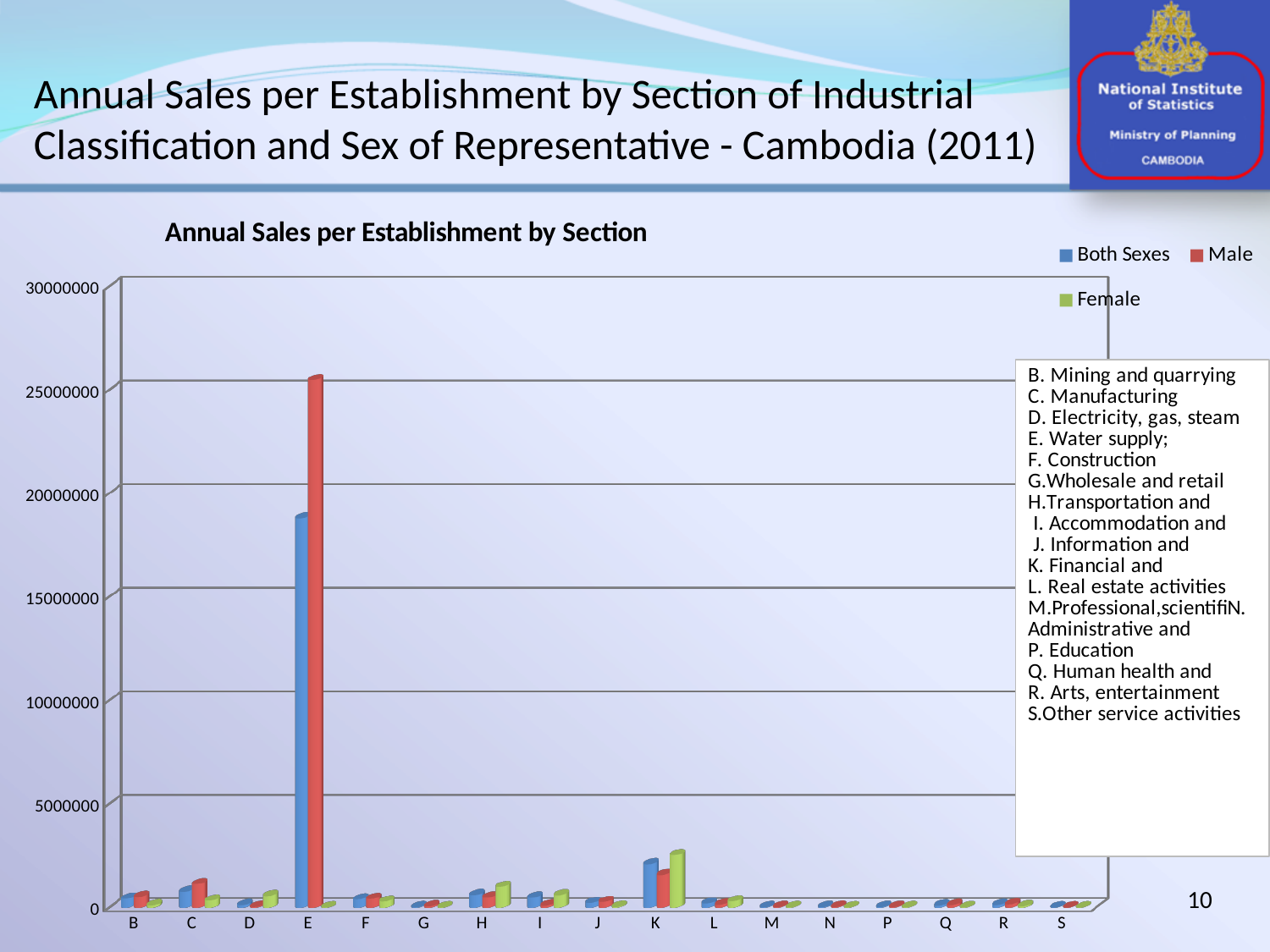
Which section has the highest Female value in the chart? K Is the Both Sexes value for section E greater or less than 15000000? greater For section K, which is larger: the Female value or the Male value? Female How many section categories are shown along the x axis of the chart? 17 What is the title of the chart? Annual Sales per Establishment by Section Is the Male value for section E greater or less than 20000000? greater For section E, which is larger: the Male value or the Both Sexes value? Male Which section has the highest Both Sexes value in the chart? E How many series does the chart legend list? 3 What kind of chart is shown on the slide? bar chart Is the Both Sexes value for section E greater or less than 20000000? less Which section has the highest Male value in the chart? E